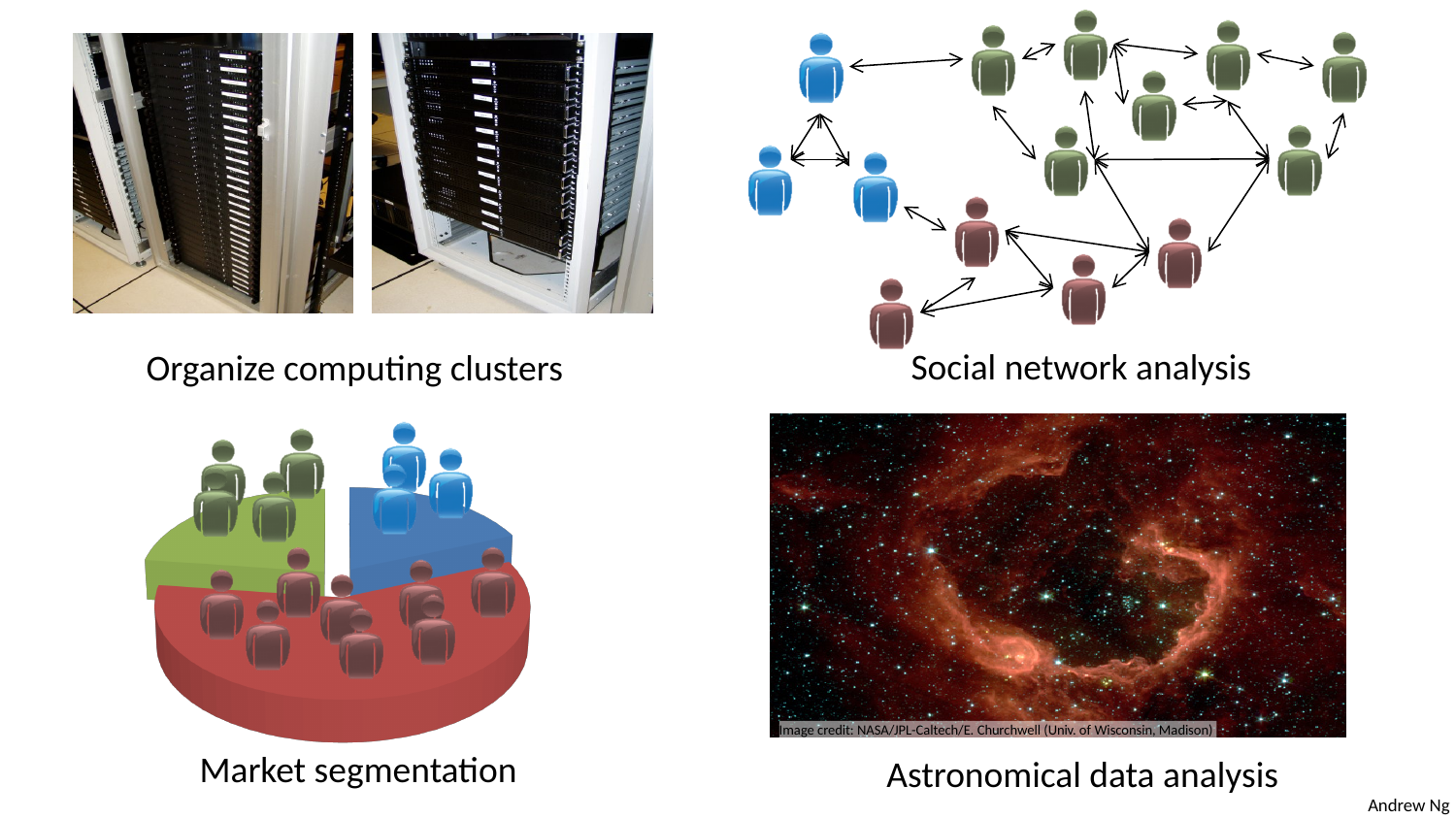
What colours are the three slices of the "Market segmentation" pie chart? green, blue and red How many slices does the pie chart under "Market segmentation" have? 3 In the "Market segmentation" pie chart, is the red slice larger or smaller than the blue slice? larger What kind of chart is shown under the "Market segmentation" label? pie chart In the "Market segmentation" pie chart, is the red slice larger or smaller than the green slice? larger In the "Market segmentation" pie chart, which colour slice is the largest? red Does the "Market segmentation" pie chart show any data labels or percentage values? No